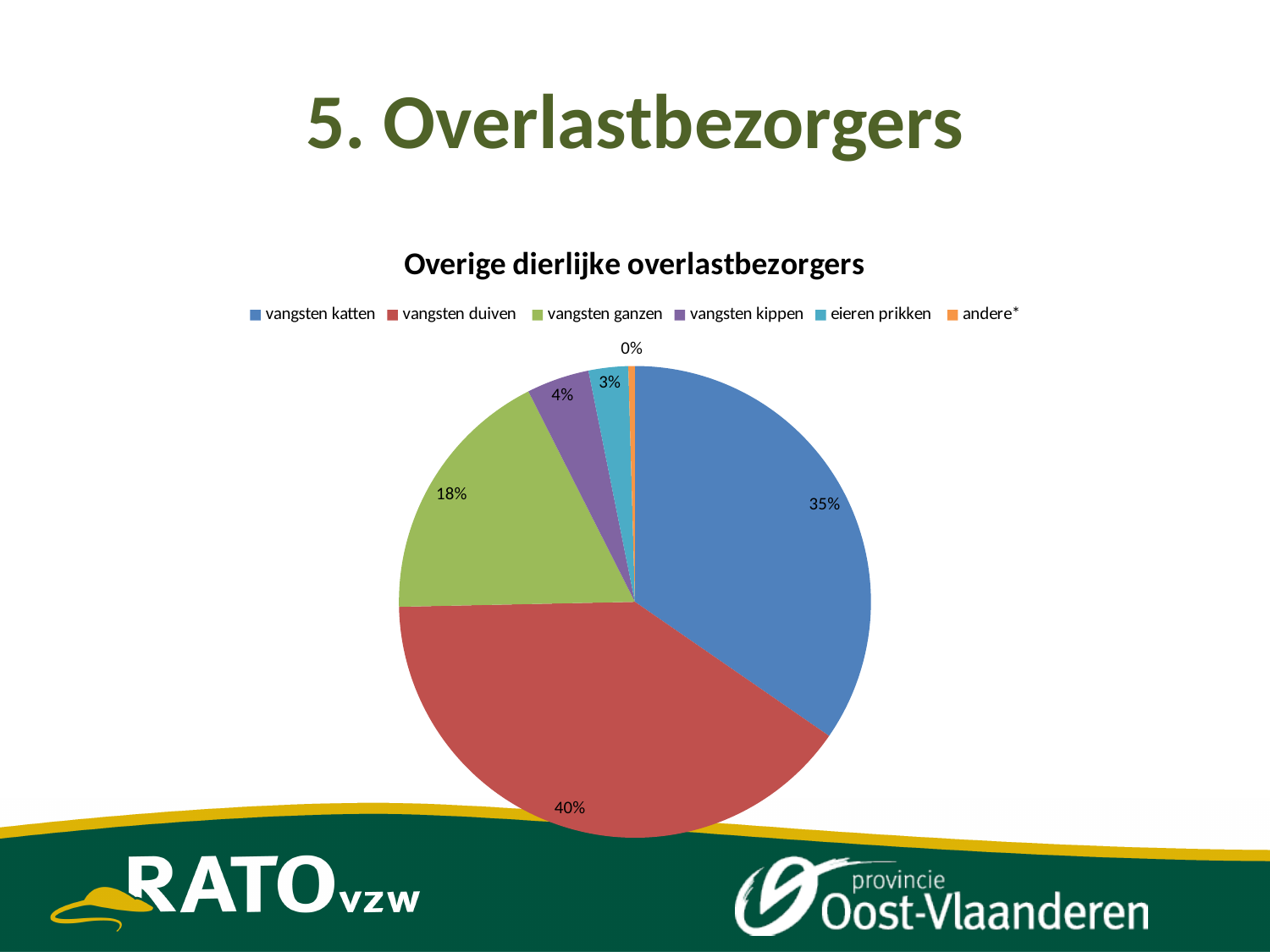
What share of the pie is 'eieren prikken'? 3% Which category has the smallest share of the pie? andere* What is the difference in share between 'vangsten duiven' and 'vangsten ganzen'? 22% How many categories does the legend list? 6 What is the title of the chart? Overige dierlijke overlastbezorgers What share of the pie is 'vangsten kippen'? 4% What share of the pie is 'vangsten ganzen'? 18% Which category has the largest share of the pie? vangsten duiven What type of chart is shown on the slide? pie chart